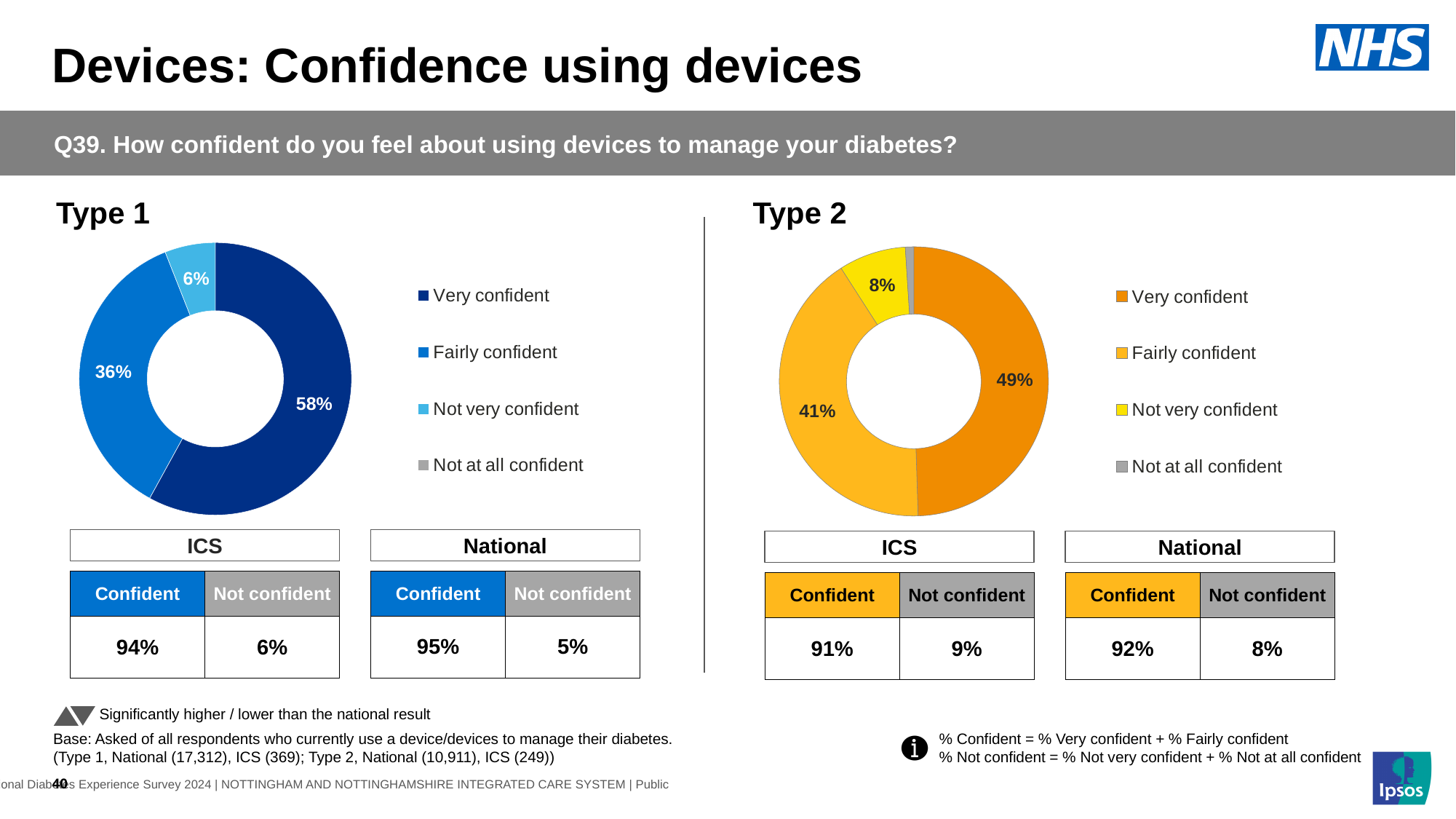
In the Type 2 chart, what percentage of respondents are not very confident? 8% In the Type 1 chart, what percentage of respondents are very confident? 58% In the Type 2 chart, which labelled category has the smallest share? Not very confident Which is larger: the very confident share in the Type 1 chart or the very confident share in the Type 2 chart? Type 1 In the Type 1 chart, what percentage of respondents are fairly confident? 36% How many entries does the legend of the Type 2 chart list? 4 In the Type 1 chart, which category has the largest share? Very confident In the Type 1 chart, what is the difference between the very confident and fairly confident shares? 22 percentage points What kind of chart is used for Type 1? Donut (pie) chart In the Type 1 chart, what percentage of respondents are not very confident? 6% In the Type 2 chart, what percentage of respondents are fairly confident? 41% In the Type 2 chart, what percentage of respondents are very confident? 49%